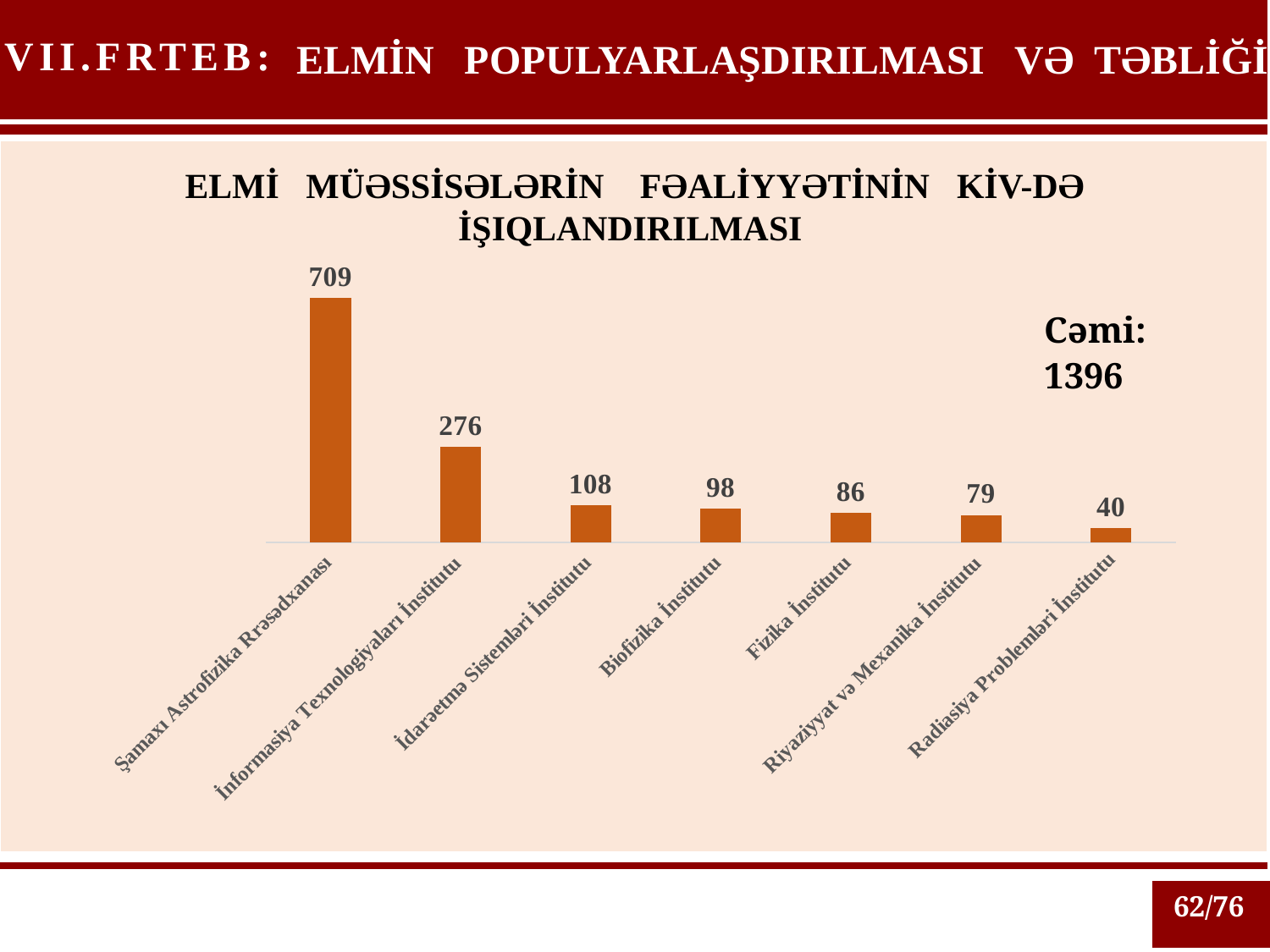
What kind of chart is shown on the slide? Bar chart Do the values rise or fall from left to right across the categories? Fall What is the value for Radiasiya Problemləri İnstitutu? 40 How many categories are shown in the chart? 7 What is the value for İnformasiya Texnologiyaları İnstitutu? 276 Which is larger, the value for Fizika İnstitutu or the value for Riyaziyyat və Mexanika İnstitutu? Fizika İnstitutu What is the difference between the values for Şamaxı Astrofizika Rəsədxanası and İnformasiya Texnologiyaları İnstitutu? 433 What is the value for Biofizika İnstitutu? 98 What total (Cəmi) is shown next to the chart? 1396 Which category has the lowest value? Radiasiya Problemləri İnstitutu Which category has the highest value? Şamaxı Astrofizika Rəsədxanası What is the value for Şamaxı Astrofizika Rəsədxanası? 709